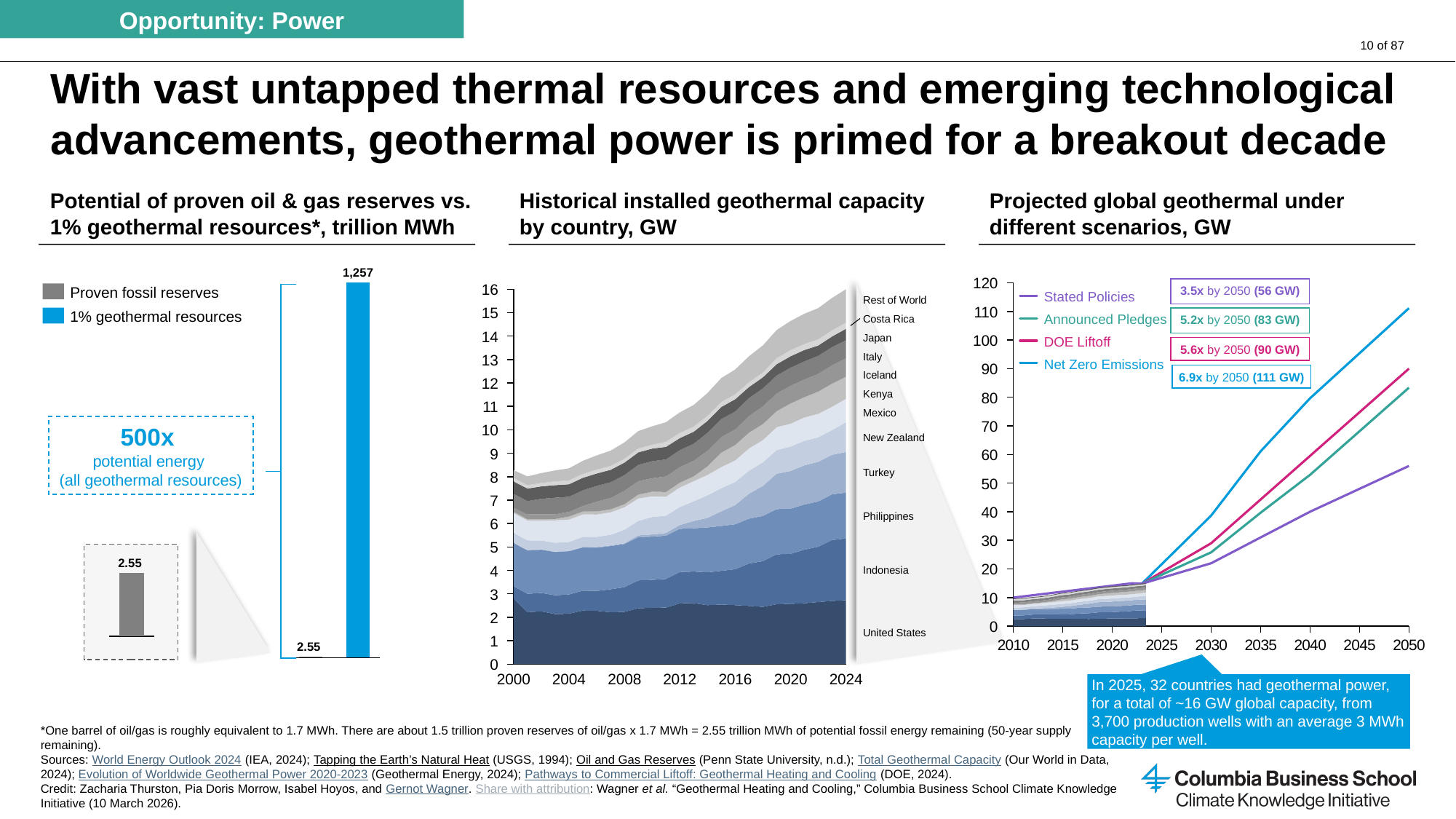
On the left chart (Potential of proven oil & gas reserves vs. 1% geothermal resources), what is the value for 1% geothermal resources? 1,257 On the left chart (Potential of proven oil & gas reserves vs. 1% geothermal resources), what is the difference between the 1% geothermal resources value and the proven fossil reserves value? 1,254.45 On the middle chart (Historical installed geothermal capacity by country), is the total installed capacity in 2024 greater or less than 14 GW? greater How many scenarios does the legend list on the right chart (Projected global geothermal under different scenarios)? 4 What kind of chart is the left chart (Potential of proven oil & gas reserves vs. 1% geothermal resources)? Bar chart How many countries or regions are labelled on the middle chart (Historical installed geothermal capacity by country)? 12 On the right chart (Projected global geothermal under different scenarios), what is the difference between the 2050 values of the Net Zero Emissions and Stated Policies scenarios? 55 GW On the middle chart (Historical installed geothermal capacity by country), does total installed capacity rise or fall from 2000 to 2024? Rise On the right chart (Projected global geothermal under different scenarios), what is the 2050 value for the Net Zero Emissions scenario? 111 GW On the left chart (Potential of proven oil & gas reserves vs. 1% geothermal resources), what is the value for proven fossil reserves? 2.55 What kind of chart is the middle chart (Historical installed geothermal capacity by country)? Stacked area chart On the right chart (Projected global geothermal under different scenarios), which scenario has the lowest value in 2050? Stated Policies